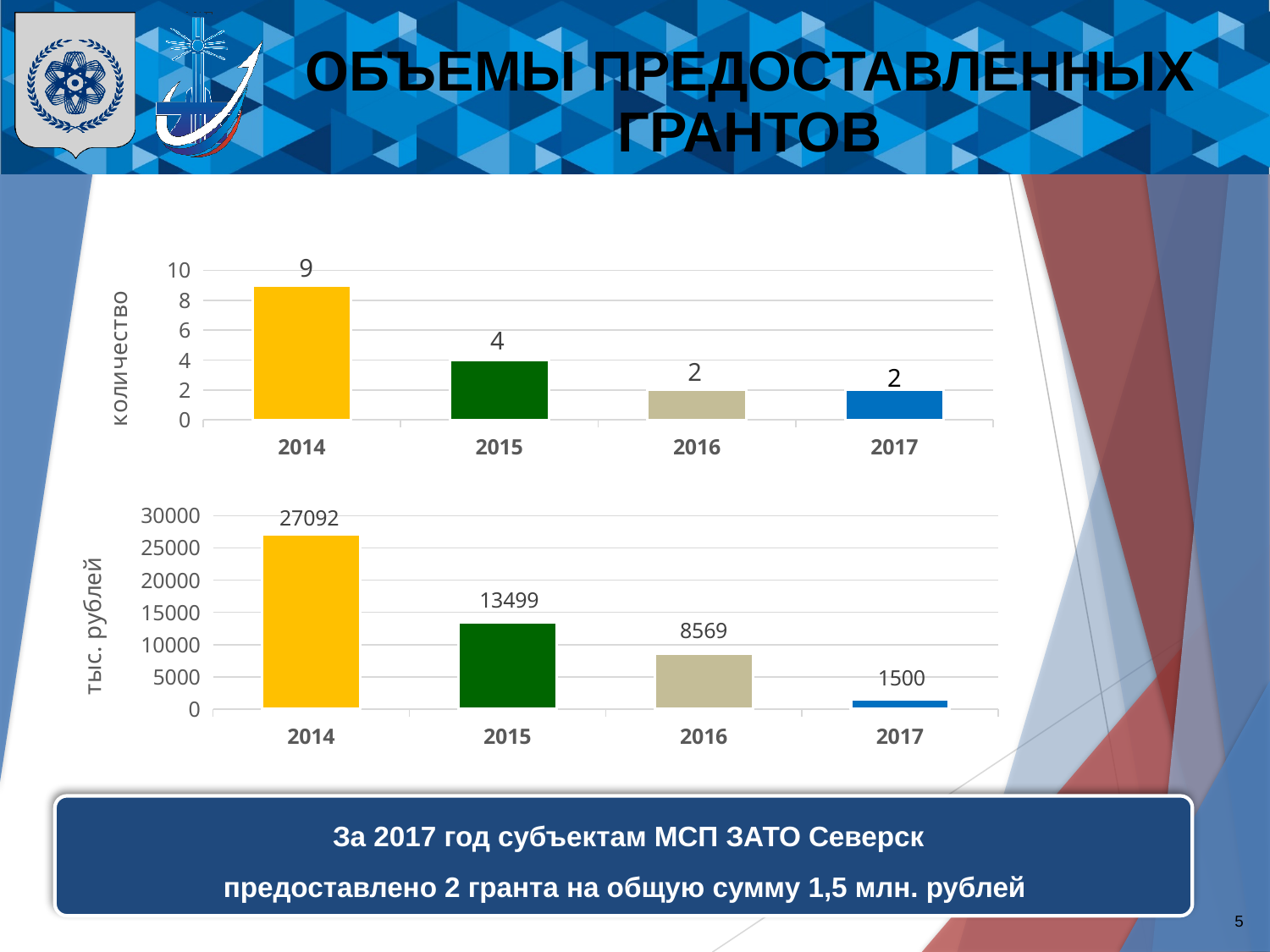
Do the values in the bottom chart (тыс. рублей) rise or fall from 2014 to 2017? fall In the top chart (количество), what is the difference between the values for 2014 and 2016? 7 In the bottom chart (тыс. рублей), which year has the lowest value? 2017 In the bottom chart (тыс. рублей), what is the value for 2017? 1500 In the bottom chart (тыс. рублей), what is the value for 2016? 8569 In the top chart (количество), what is the value for 2014? 9 In the top chart (количество), what is the value for 2015? 4 In the bottom chart (тыс. рублей), which year has the highest value? 2014 In the top chart (количество), which year has the highest value? 2014 How many years are shown on the x axis of the top chart (количество)? 4 In the bottom chart (тыс. рублей), what is the difference between the values for 2014 and 2015? 13593 In the bottom chart (тыс. рублей), is the value for 2015 greater or less than 10000? greater